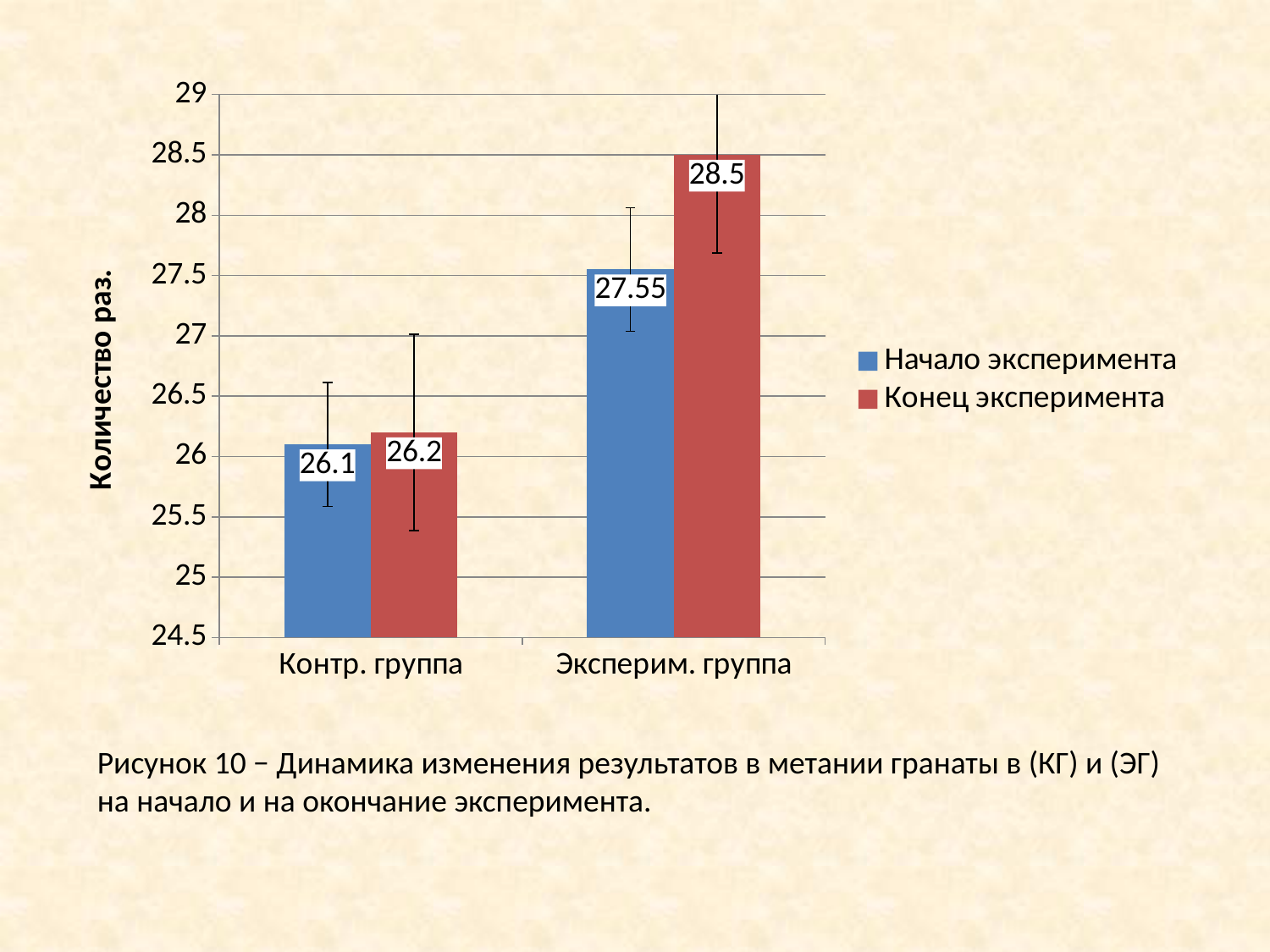
What is the value for Контр. группа in the Конец эксперимента series? 26.2 How many groups are shown on the x axis? 2 What is the value for Эксперим. группа in the Конец эксперимента series? 28.5 Which group has the lowest value in the Начало эксперимента series? Контр. группа What is the value for Контр. группа in the Начало эксперимента series? 26.1 What kind of chart is shown on the slide? Bar chart Which is larger: the Конец эксперимента value for Контр. группа or the Начало эксперимента value for Эксперим. группа? Начало эксперимента value for Эксперим. группа How many series does the legend list? 2 What is the difference between the Конец эксперимента and Начало эксперимента values for Эксперим. группа? 0.95 What is the difference between the Начало эксперимента values for Эксперим. группа and Контр. группа? 1.45 Which group has the highest value in the Конец эксперимента series? Эксперим. группа What is the value for Эксперим. группа in the Начало эксперимента series? 27.55